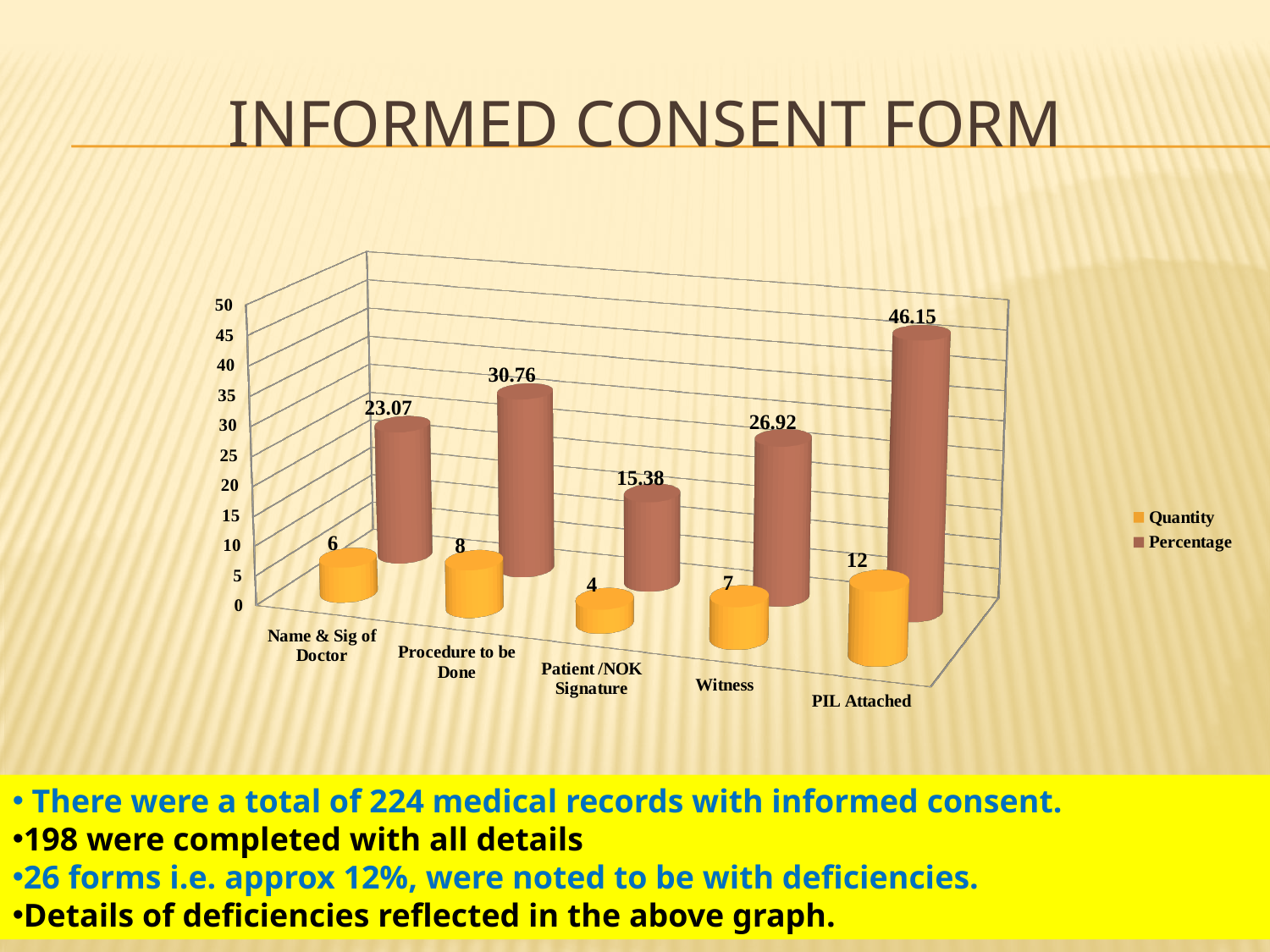
Which series is shown in brown in the legend? Percentage Which category has the highest Quantity? PIL Attached Which category has the lowest Percentage? Patient /NOK Signature What kind of chart is shown on the slide? Bar chart What is the difference between the Quantity for PIL Attached and the Quantity for Name & Sig of Doctor? 6 What is the Quantity value for Patient /NOK Signature? 4 How many categories are shown on the x axis? 5 How many series does the legend list? 2 What is the total of the Quantity values across all five categories? 37 What is the Percentage value for PIL Attached? 46.15 What is the Percentage value for Witness? 26.92 Which is larger, the Percentage for Procedure to be Done or the Percentage for Witness? Procedure to be Done